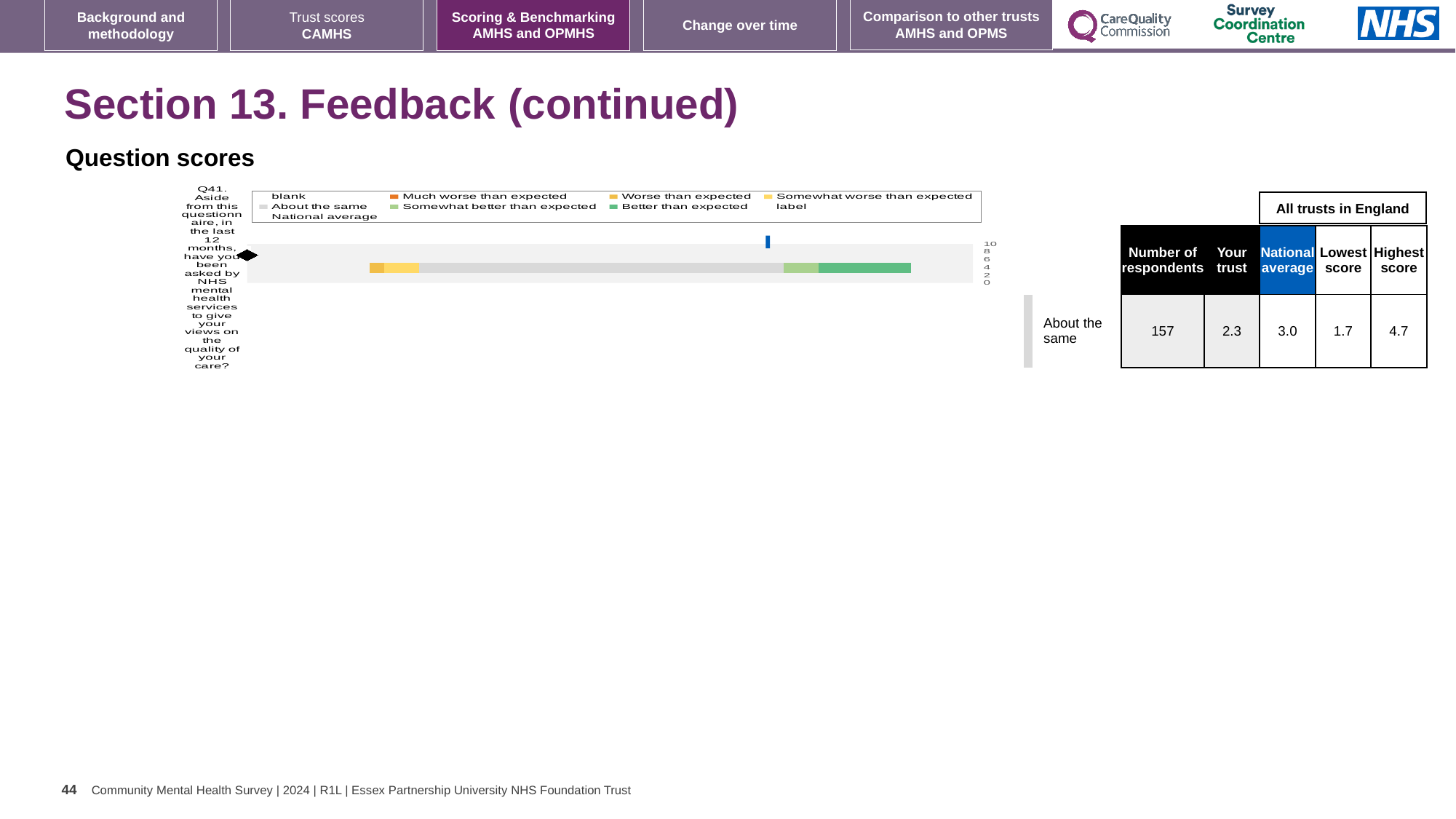
How many question categories are plotted in the chart? 1 In the table next to the chart, what is the highest score among all trusts in England for Q41? 4.7 In the table next to the chart, what is the difference between the highest score and the lowest score for Q41? 3.0 What kind of chart is shown on the slide? bar chart In the table next to the chart, which is larger for Q41: the 'Your trust' score or the national average? national average In the table next to the chart, what is the lowest score among all trusts in England for Q41? 1.7 In the table next to the chart, what is the national average for Q41? 3.0 How many entries does the chart's legend list? 9 In the table next to the chart, what is the number of respondents for Q41? 157 What colour does the legend use for 'Better than expected'? green In the table next to the chart, what is the 'Your trust' score for Q41? 2.3 Which question number is plotted in the chart? Q41